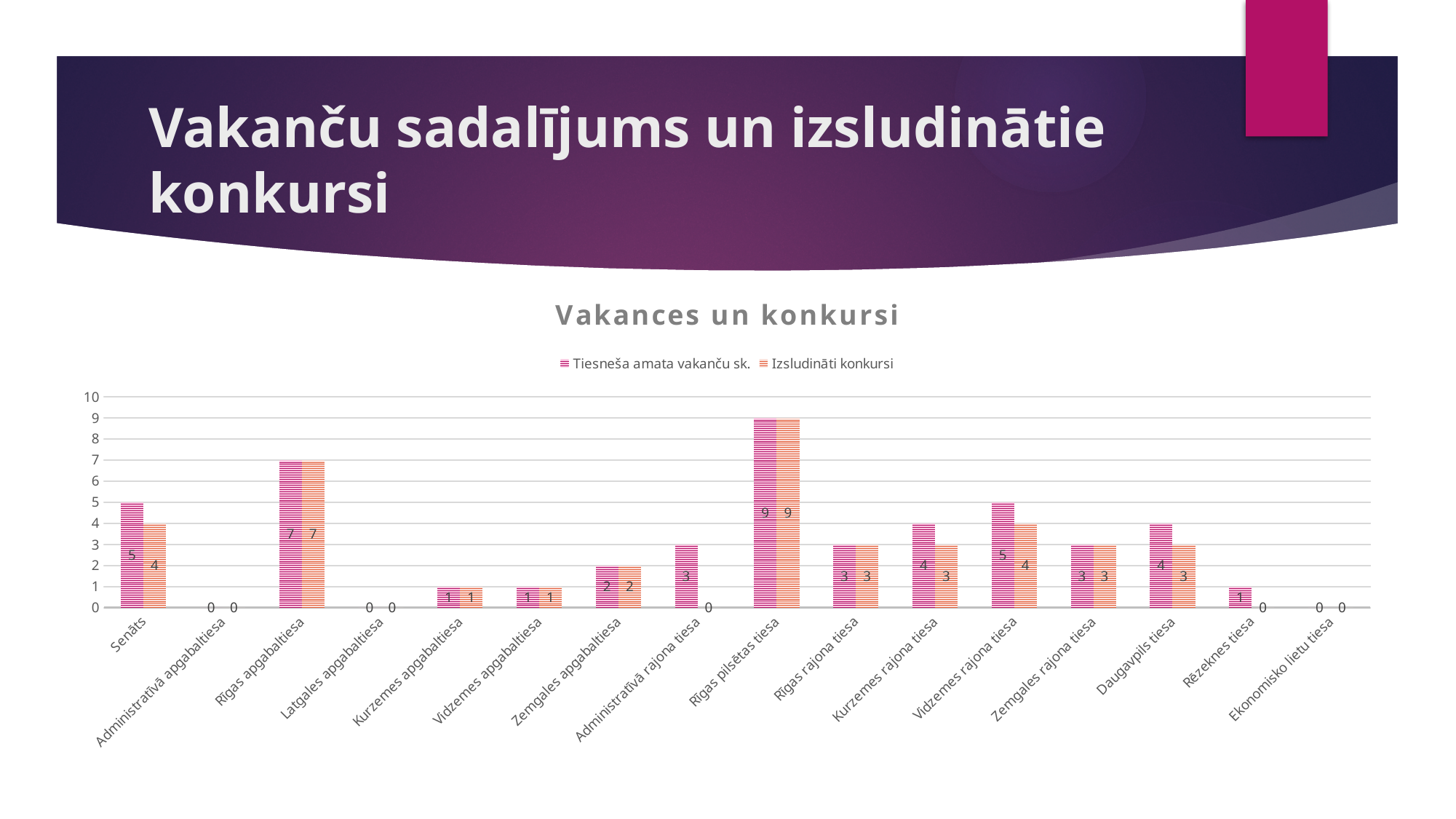
What is the value of "Tiesneša amata vakanču sk." for Senāts? 5 Which is larger for Daugavpils tiesa: "Tiesneša amata vakanču sk." or "Izsludināti konkursi"? Tiesneša amata vakanču sk. What is the value of "Tiesneša amata vakanču sk." for Rēzeknes tiesa? 1 Which category has the highest value for "Tiesneša amata vakanču sk."? Rīgas pilsētas tiesa What is the difference between "Tiesneša amata vakanču sk." and "Izsludināti konkursi" for Vidzemes rajona tiesa? 1 What is the value of "Tiesneša amata vakanču sk." for Rīgas apgabaltiesa? 7 What is the title of the chart? Vakances un konkursi What is the value of "Izsludināti konkursi" for Administratīvā rajona tiesa? 0 How many categories are shown on the x axis? 16 How many series does the legend list? 2 What is the value of "Izsludināti konkursi" for Kurzemes rajona tiesa? 3 What kind of chart is shown on the slide? Bar chart